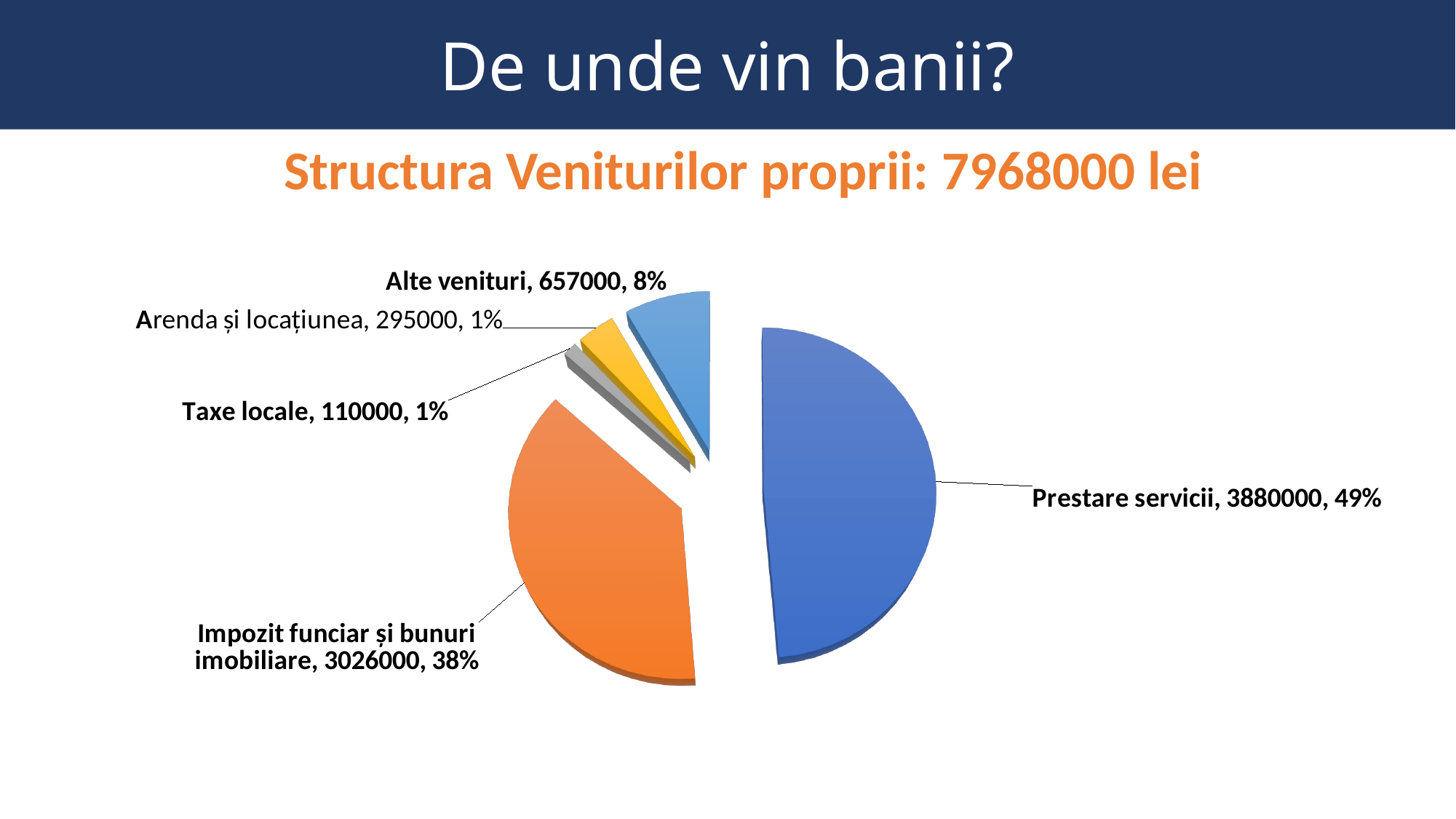
What share of the pie does Impozit funciar și bunuri imobiliare represent? 38% Which category has the largest slice of the pie? Prestare servicii Which category has the smallest value? Taxe locale What is the value for Impozit funciar și bunuri imobiliare? 3026000 What is the value for Alte venituri? 657000 What total amount is stated in the chart heading for Structura Veniturilor proprii? 7968000 lei What is the difference between the values for Prestare servicii and Impozit funciar și bunuri imobiliare? 854000 Which is larger, the value for Alte venituri or the value for Arenda și locațiunea? Alte venituri What kind of chart is shown on the slide? pie chart What is the value for Prestare servicii? 3880000 What is the value for Taxe locale? 110000 How many slices does the pie chart have? 5